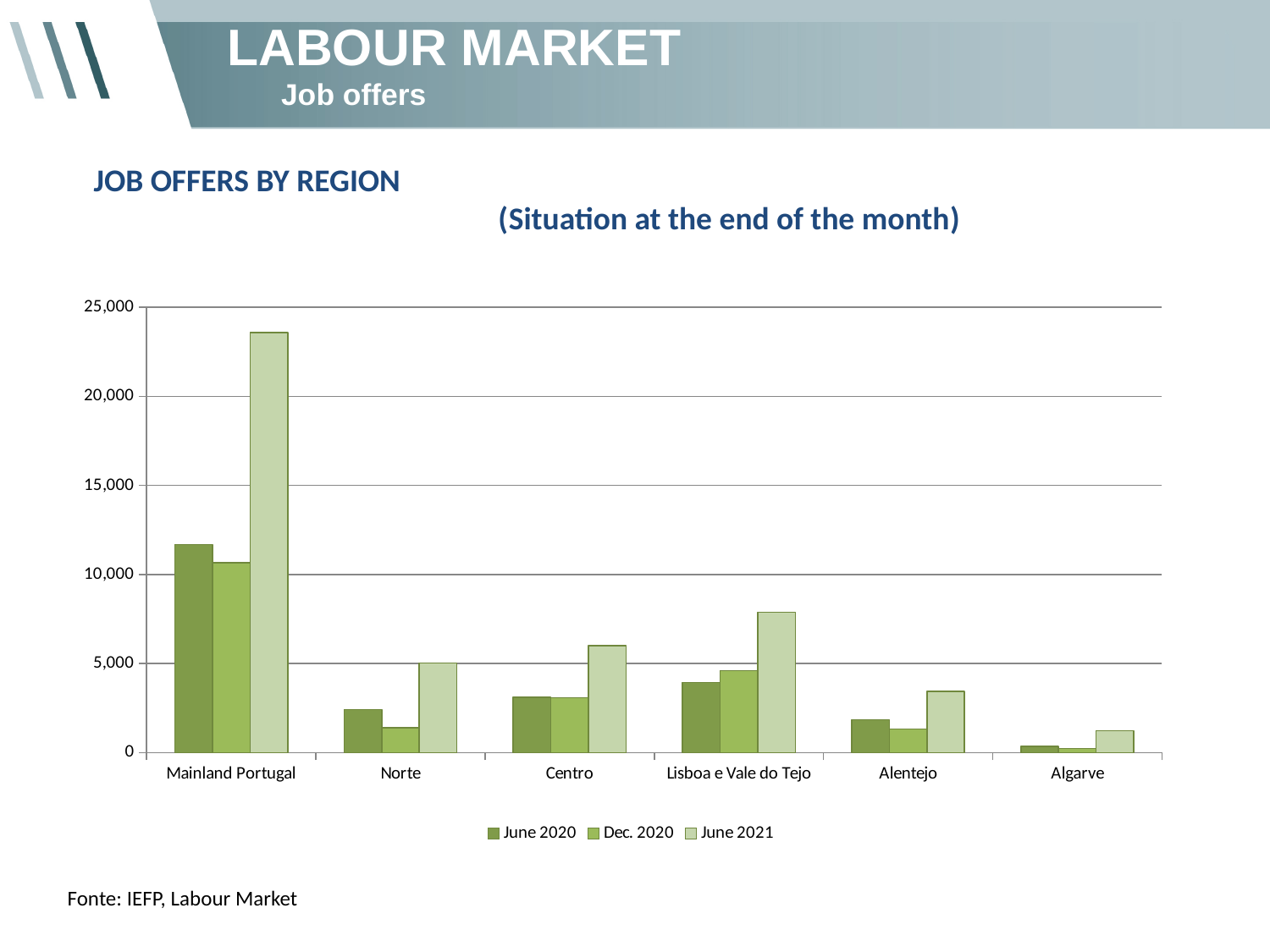
How many series does the legend list? 3 Is the June 2021 value for Mainland Portugal greater or less than 20,000? greater What are the three series listed in the legend? June 2020, Dec. 2020, June 2021 What kind of chart is shown on the slide? Bar chart How many regions are shown on the x axis? 6 Which region has the highest June 2021 value? Mainland Portugal Which region has the lowest June 2021 value? Algarve For Mainland Portugal, which is larger: the June 2020 value or the Dec. 2020 value? June 2020 Is the June 2021 value for Alentejo greater or less than 5,000? less Is the June 2020 value for Mainland Portugal greater or less than 10,000? greater Which is larger for June 2021: Lisboa e Vale do Tejo or Centro? Lisboa e Vale do Tejo